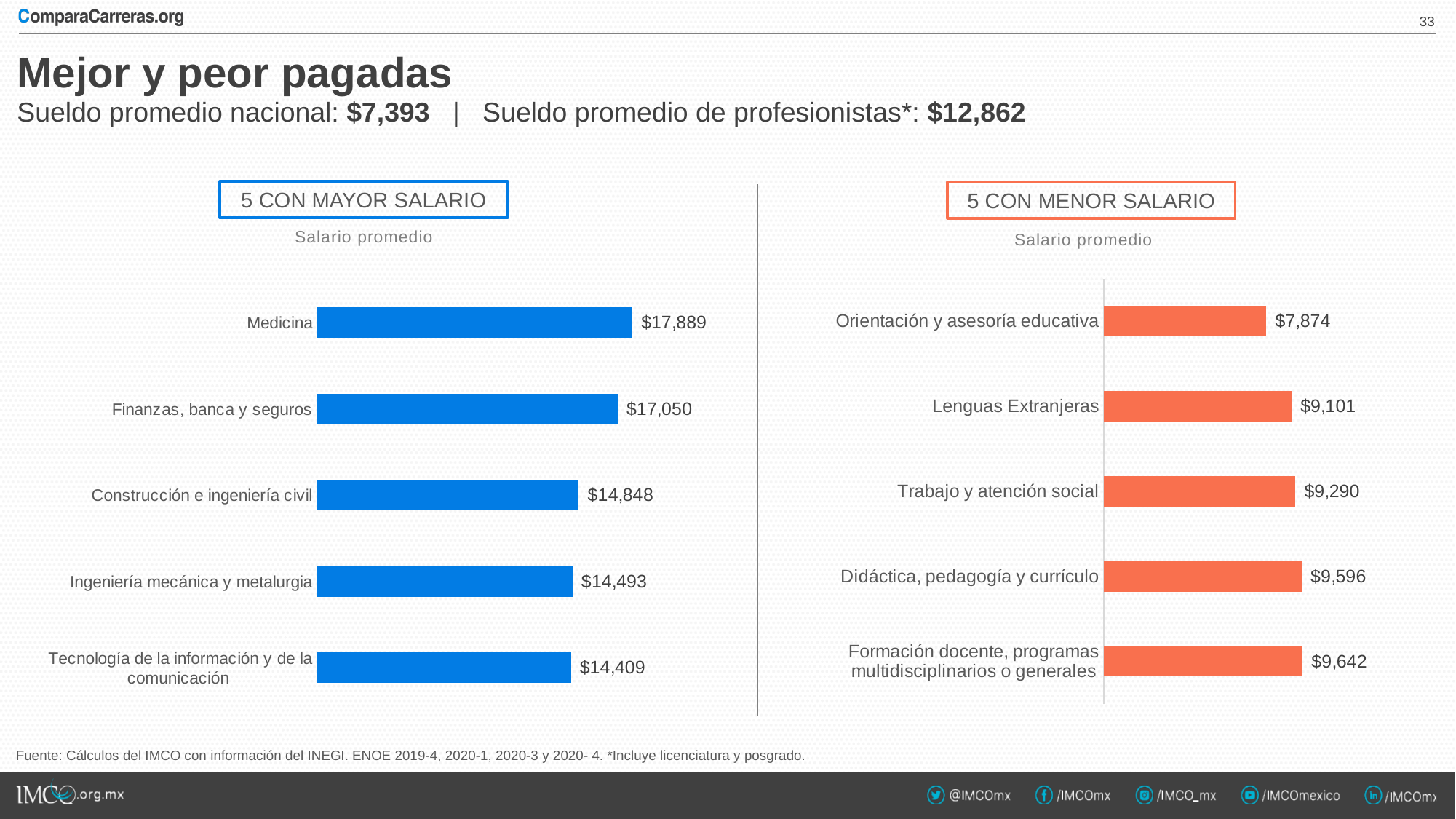
What type of chart is the '5 CON MENOR SALARIO' chart? Bar chart In the '5 CON MENOR SALARIO' chart, which is larger: Trabajo y atención social or Lenguas Extranjeras? Trabajo y atención social In the '5 CON MAYOR SALARIO' chart, what is the average salary for Medicina? $17,889 How many categories are shown in the '5 CON MAYOR SALARIO' chart? 5 In the '5 CON MENOR SALARIO' chart, what is the difference between Formación docente, programas multidisciplinarios o generales and Orientación y asesoría educativa? $1,768 In the '5 CON MENOR SALARIO' chart, do the values rise or fall from top to bottom? Rise In the '5 CON MAYOR SALARIO' chart, what is the value for Construcción e ingeniería civil? $14,848 In the '5 CON MAYOR SALARIO' chart, what is the difference between Medicina and Finanzas, banca y seguros? $839 In the '5 CON MENOR SALARIO' chart, what is the average salary for Lenguas Extranjeras? $9,101 What colour are the bars in the '5 CON MAYOR SALARIO' chart? Blue In the '5 CON MAYOR SALARIO' chart, which category has the highest average salary? Medicina In the '5 CON MENOR SALARIO' chart, which category has the lowest average salary? Orientación y asesoría educativa